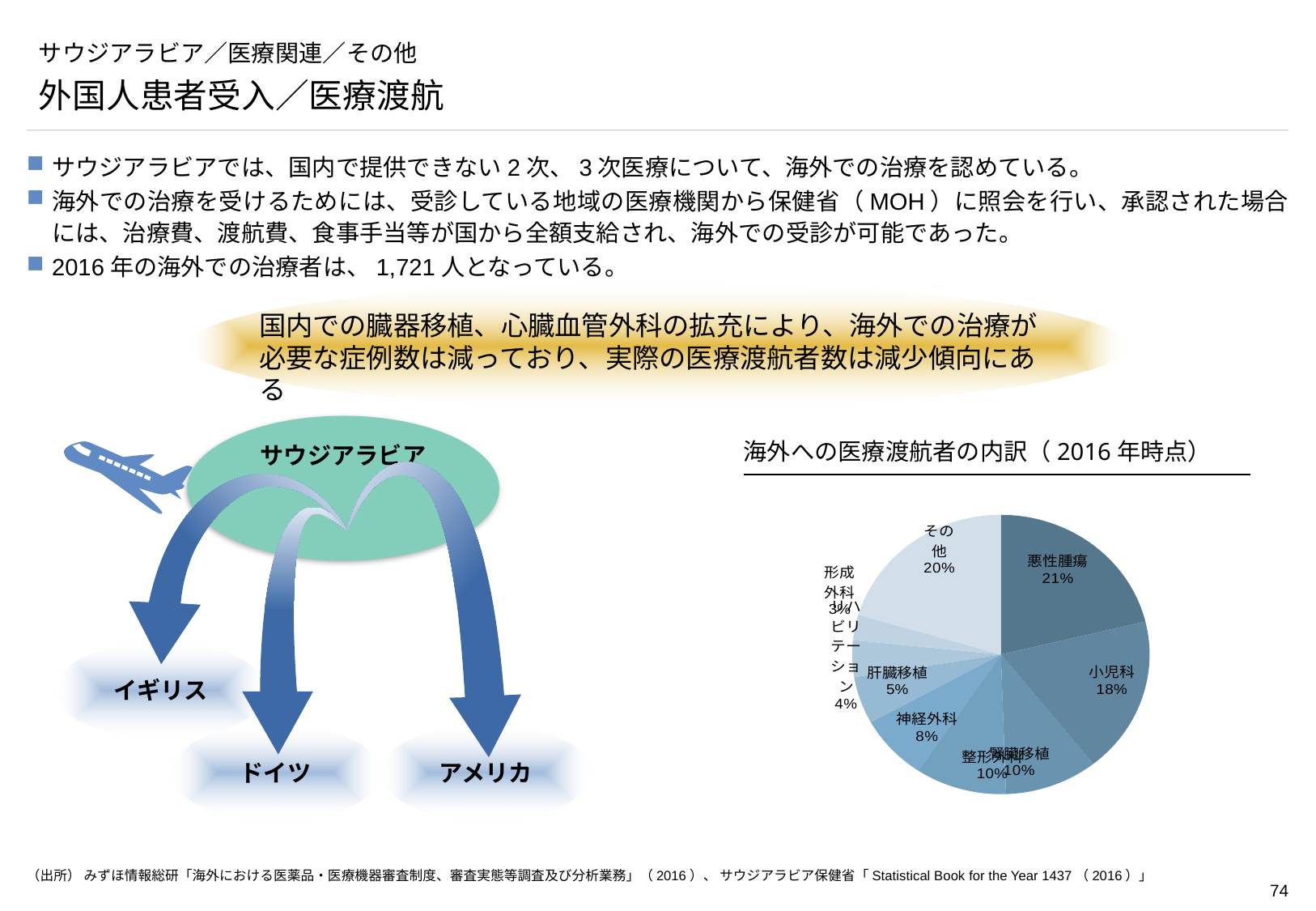
In the pie chart 海外への医療渡航者の内訳（2016年時点）, which category has the largest share? 悪性腫瘍 In the pie chart 海外への医療渡航者の内訳（2016年時点）, which category has the smallest share? 形成外科 In the pie chart 海外への医療渡航者の内訳（2016年時点）, how many percentage points larger is 悪性腫瘍 than 小児科? 3 In the pie chart 海外への医療渡航者の内訳（2016年時点）, what share is 肝臓移植? 5% In the pie chart 海外への医療渡航者の内訳（2016年時点）, what share is 形成外科? 3% In the pie chart 海外への医療渡航者の内訳（2016年時点）, what share is 神経外科? 8% What kind of chart is shown under the title 海外への医療渡航者の内訳（2016年時点）? pie chart In the pie chart 海外への医療渡航者の内訳（2016年時点）, what share is その他? 20% In the pie chart 海外への医療渡航者の内訳（2016年時点）, which is larger, 神経外科 or 肝臓移植? 神経外科 In the pie chart 海外への医療渡航者の内訳（2016年時点）, what share is 悪性腫瘍? 21% In the pie chart 海外への医療渡航者の内訳（2016年時点）, what share is 小児科? 18% How many slices does the pie chart 海外への医療渡航者の内訳（2016年時点） have? 9